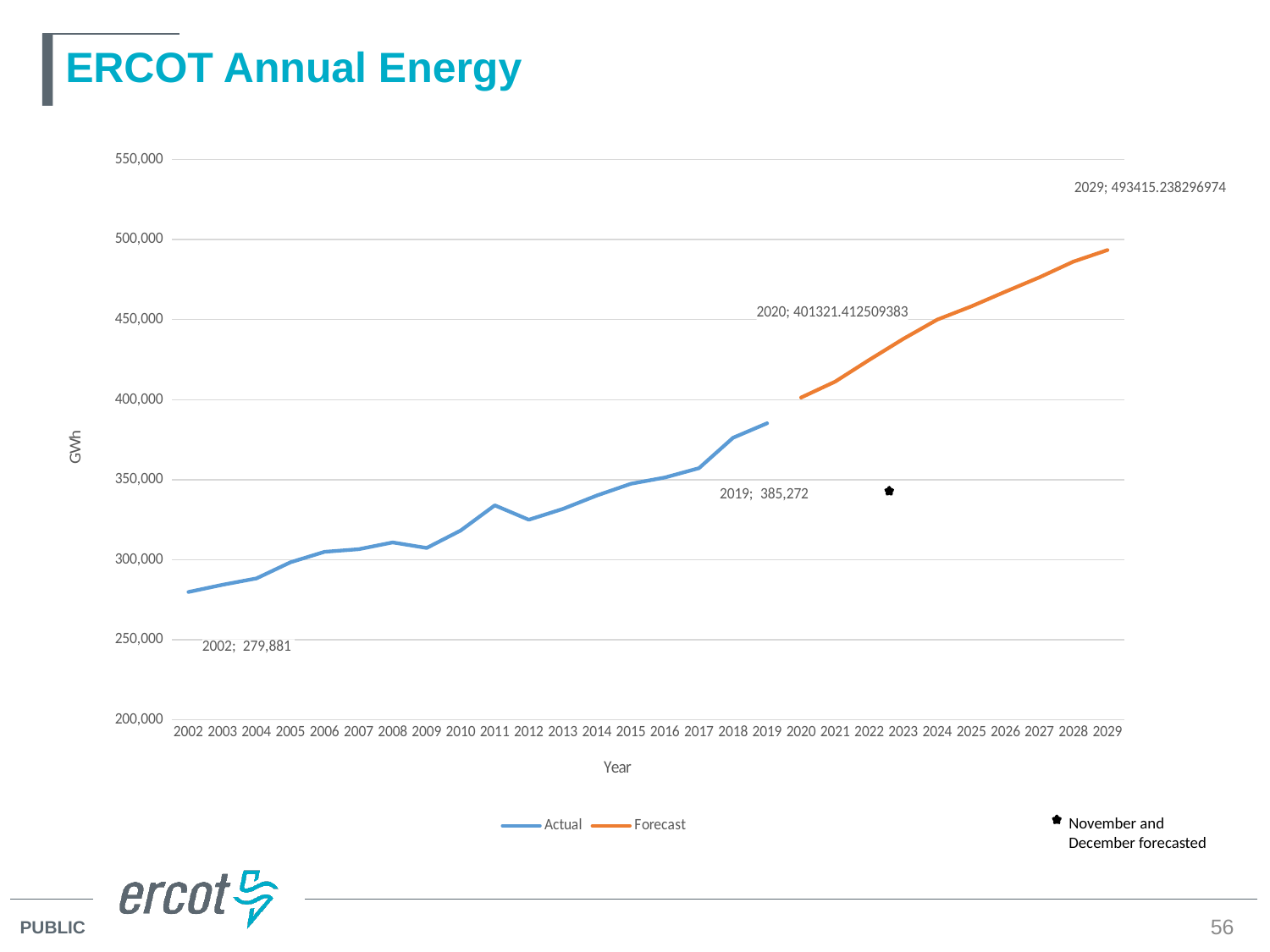
What is the Forecast value for 2029? 493415.238296974 What is the Forecast value for 2020? 401321.412509383 Is the Forecast value for 2026 greater or less than 450,000? greater What type of chart is shown on the slide? line chart How many series does the legend list? 2 Which year has the highest value on the chart? 2029 What is the Actual value for 2002? 279,881 What is the Actual value for 2019? 385,272 What is the difference between the Actual values for 2019 and 2002? 105,391 What is the label on the vertical axis? GWh Is the Actual value for 2011 greater or less than 350,000? less Do the values generally rise or fall from 2002 to 2029? rise